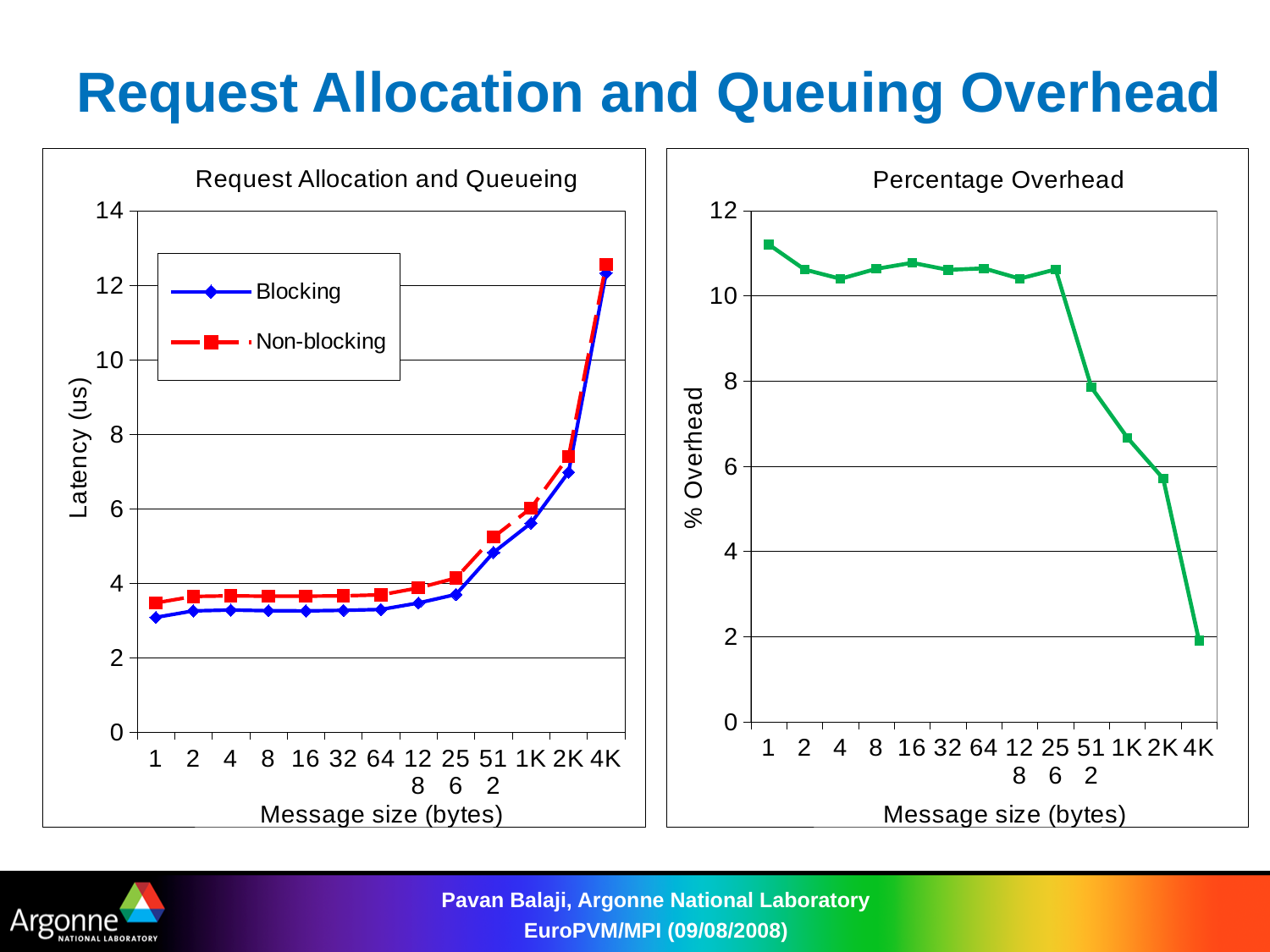
What kind of chart is the "Request Allocation and Queueing" chart on the left? line chart What is the y-axis label of the "Request Allocation and Queueing" chart? Latency (us) In the "Percentage Overhead" chart, at which message size is the overhead lowest? 4K How many message sizes are plotted along the x axis of the "Percentage Overhead" chart? 13 In the "Request Allocation and Queueing" chart, which series has the higher latency at message size 512, Blocking or Non-blocking? Non-blocking In the "Request Allocation and Queueing" chart, is the Non-blocking latency at 4K greater or less than 12? greater In the "Percentage Overhead" chart, is the overhead at message size 1 greater or less than 10? greater In the "Request Allocation and Queueing" chart, at which message size is the Blocking latency highest? 4K How many series does the legend of the "Request Allocation and Queueing" chart list? 2 In the "Percentage Overhead" chart, does the overhead rise or fall from 256 to 4K? fall In the "Request Allocation and Queueing" chart, is the Blocking latency at message size 1 greater or less than 4? less